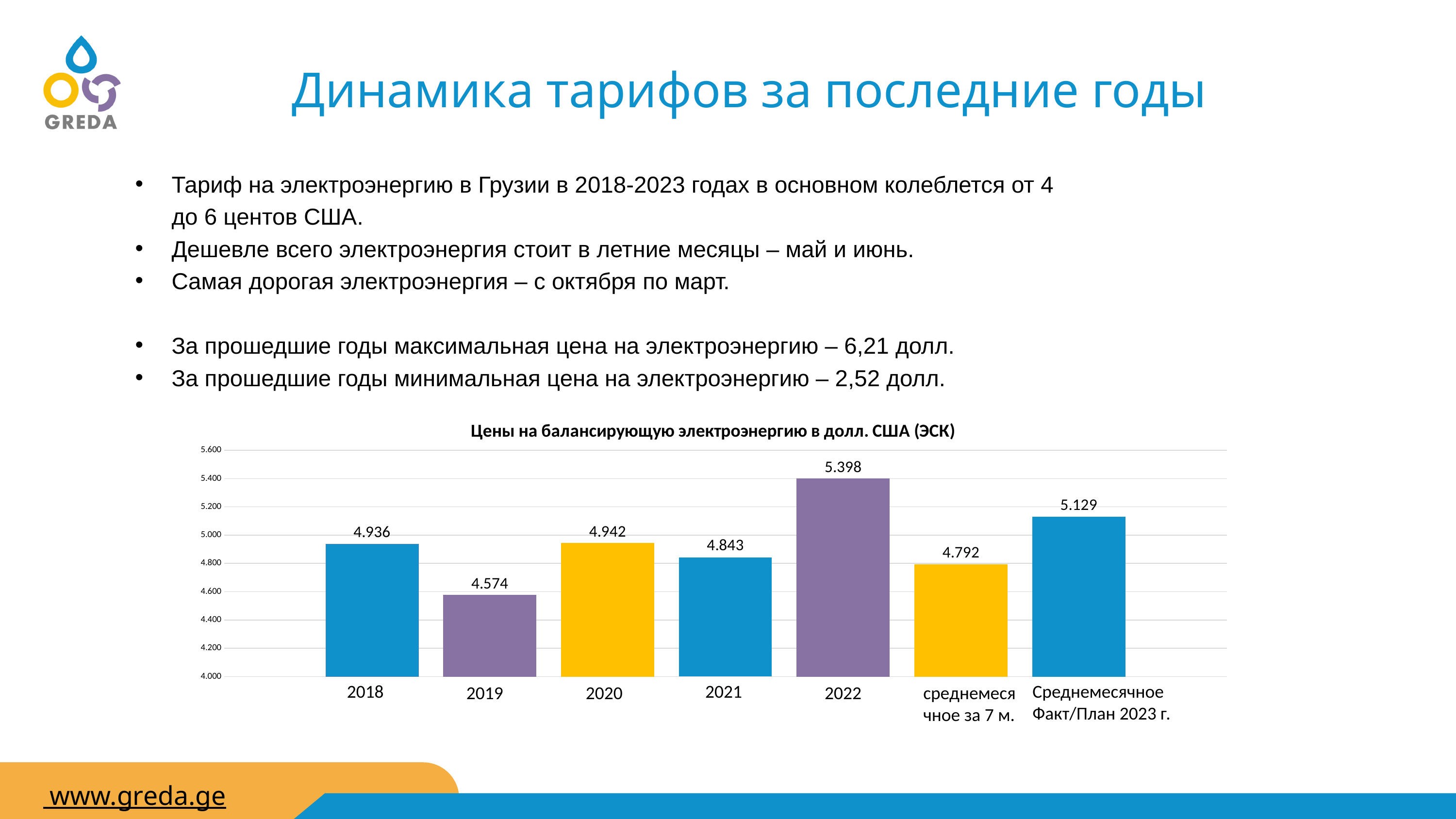
What is the value for 2022 in the chart? 5.398 What is the value for "среднемесячное за 7 м." in the chart? 4.792 What is the difference between the values for 2022 and 2019? 0.824 What is the difference between the values for "Среднемесячное Факт/План 2023 г." and "среднемесячное за 7 м."? 0.337 Is the value for 2019 greater or less than 4.800? less How many categories are shown on the x axis of the chart? 7 What is the value for "Среднемесячное Факт/План 2023 г." in the chart? 5.129 What is the value for 2019 in the chart? 4.574 Which category has the lowest value in the chart? 2019 What type of chart is shown on the slide? bar chart Which category has the highest value in the chart? 2022 Which is larger, the value for 2021 or the value for 2018? 2018